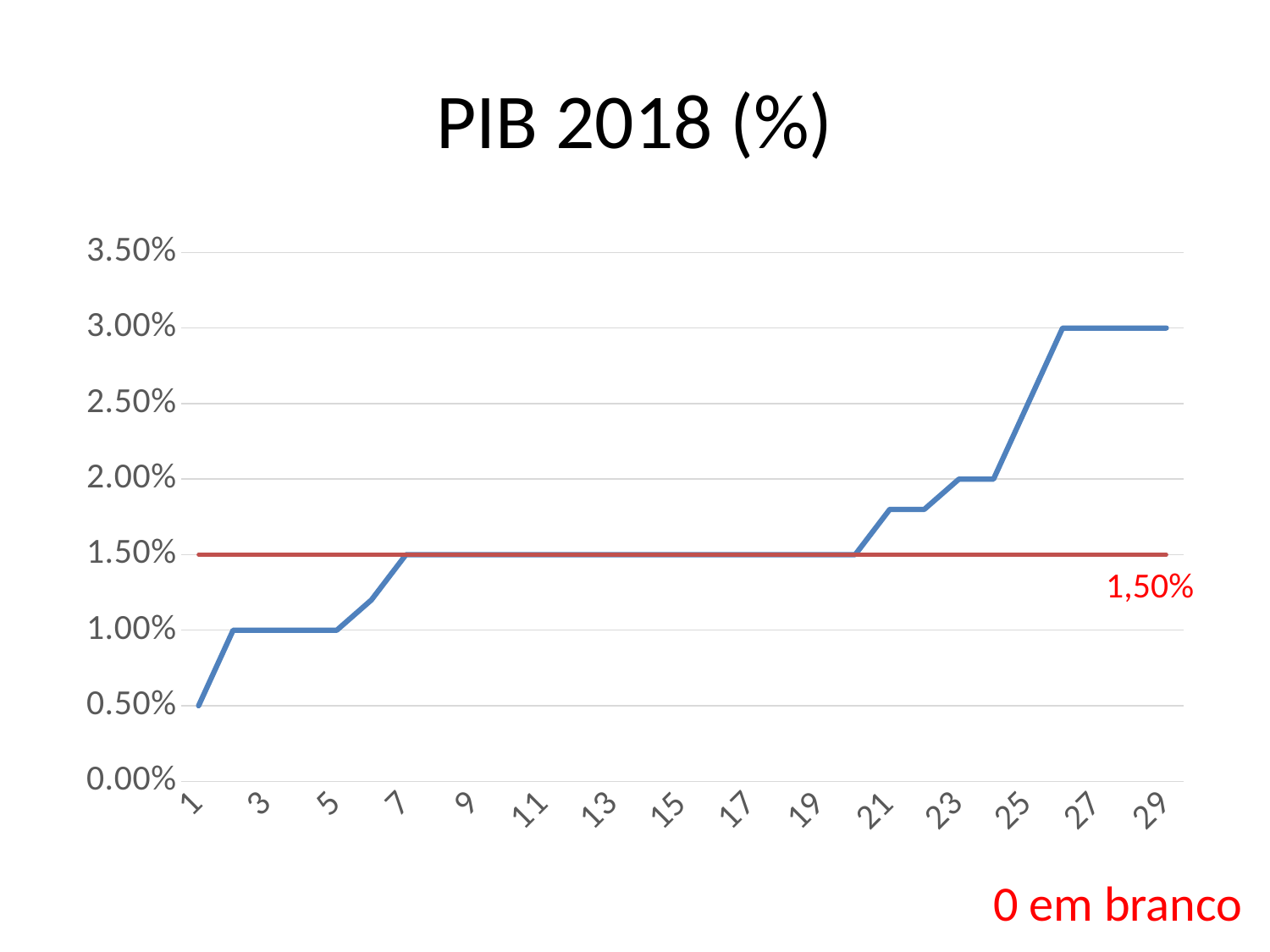
Does the blue line generally rise or fall from point 1 to point 29? rise What kind of chart is shown on the slide? line chart Which is larger, the value at point 1 or the value at point 29? point 29 What is the value of the blue line at point 1? 0.50% What is the value of the blue line at point 3? 1.00% What value does the red horizontal reference line mark, as labelled on the chart? 1,50% What is the lowest value of the blue line? 0.50% What is the value of the blue line at point 29? 3.00% What is the title of the chart? PIB 2018 (%) Is the value of the blue line at point 5 greater or less than 1.50%? less Is the value of the blue line at point 21 greater or less than 1.50%? greater What is the highest value reached by the blue line? 3.00%